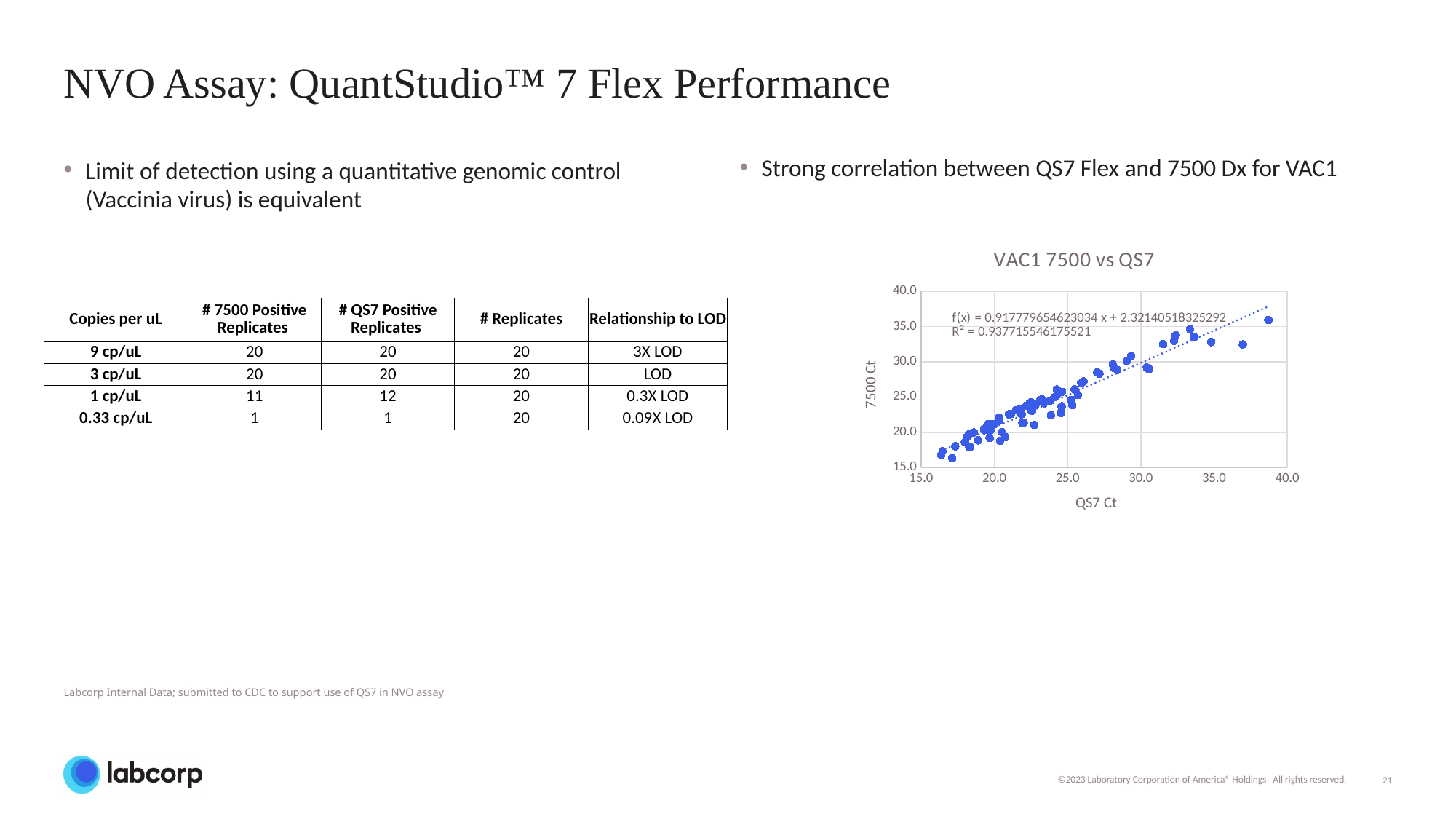
What is the maximum value shown on the y axis of the 'VAC1 7500 vs QS7' chart? 40.0 What trendline equation is printed on the 'VAC1 7500 vs QS7' chart? f(x) = 0.917779654623034 x + 2.32140518325292 In the 'VAC1 7500 vs QS7' chart, do the 7500 Ct values rise or fall as QS7 Ct increases? Rise What is the label of the x axis of the 'VAC1 7500 vs QS7' chart? QS7 Ct In the 'VAC1 7500 vs QS7' chart, is the 7500 Ct value of the highest point greater or less than 35.0? greater What is the title of the chart on the slide? VAC1 7500 vs QS7 What is the minimum value shown on the x axis of the 'VAC1 7500 vs QS7' chart? 15.0 What kind of chart is the 'VAC1 7500 vs QS7' chart? Scatter chart What R² value is printed on the 'VAC1 7500 vs QS7' chart? 0.937715546175521 In the 'VAC1 7500 vs QS7' chart, is the QS7 Ct value of the rightmost point greater or less than 35.0? greater In the 'VAC1 7500 vs QS7' chart, is the 7500 Ct value of the lowest point greater or less than 20.0? less